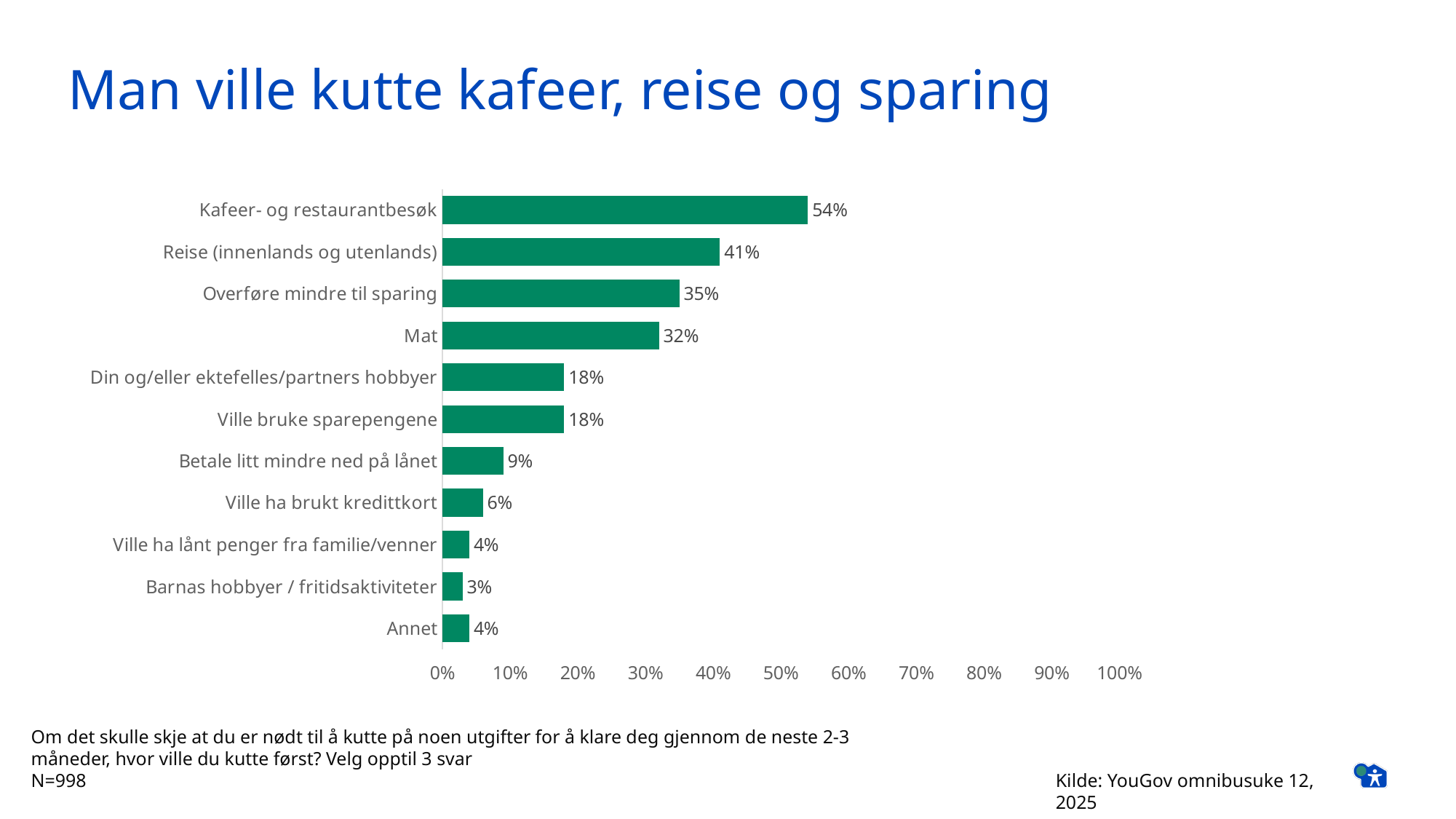
What is the value for Betale litt mindre ned på lånet? 9% What kind of chart is shown on the slide? bar chart What is the title of the slide? Man ville kutte kafeer, reise og sparing How many categories are shown in the chart? 11 Which category has the highest value? Kafeer- og restaurantbesøk What is the value for Kafeer- og restaurantbesøk? 54% What is the value for Annet? 4% Which is larger, the value for Ville ha brukt kredittkort or the value for Ville ha lånt penger fra familie/venner? Ville ha brukt kredittkort What is the difference between the values for Reise (innenlands og utenlands) and Mat? 9% Which category has the lowest value? Barnas hobbyer / fritidsaktiviteter Is the value for Reise (innenlands og utenlands) greater or less than 50%? less What is the value for Overføre mindre til sparing? 35%